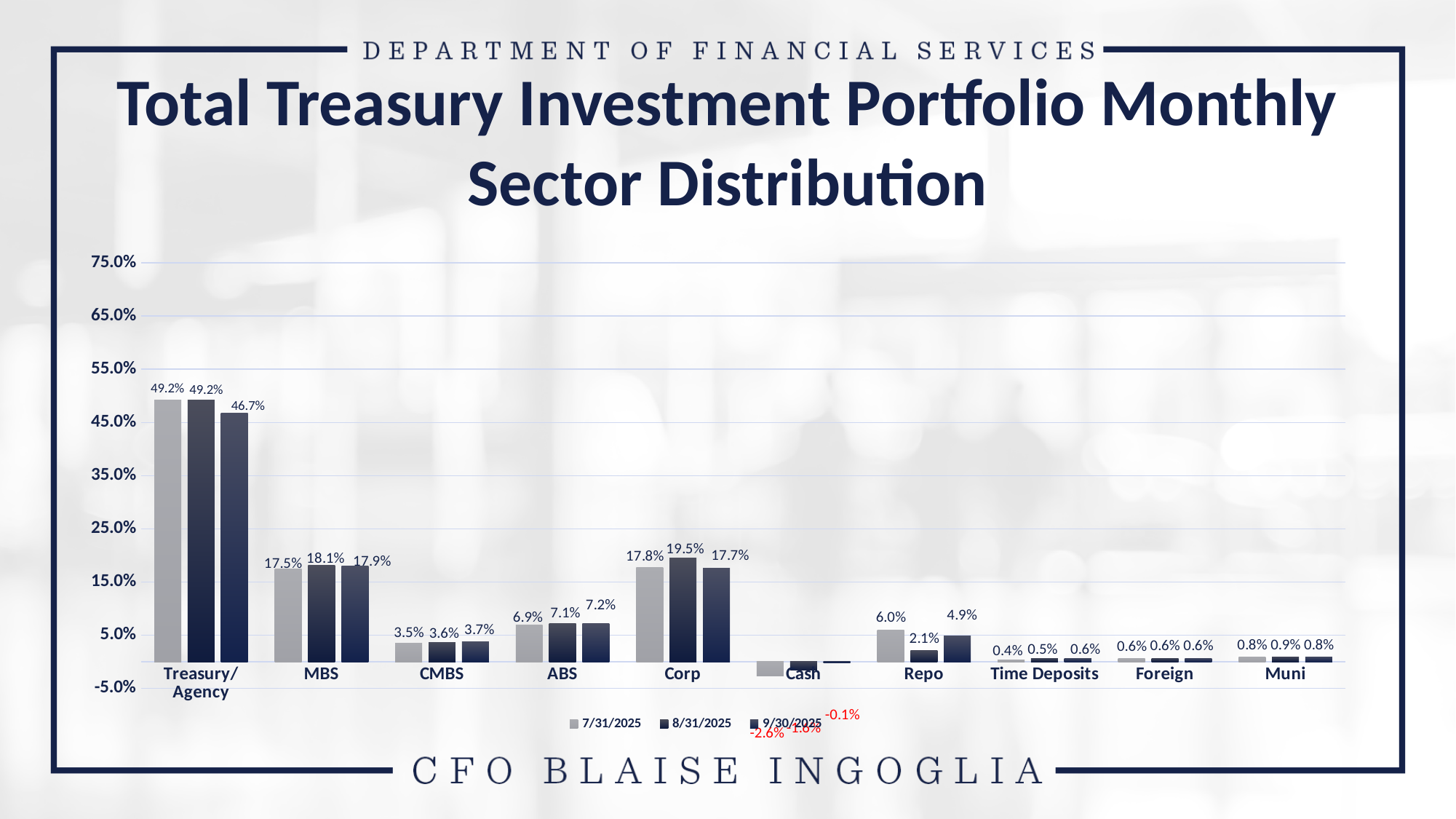
What is the value for Repo in the 7/31/2025 series? 6.0% What is the value for Cash in the 7/31/2025 series? -2.6% How many sectors are shown on the x axis? 10 What is the difference between the 8/31/2025 and 9/30/2025 values for Corp? 1.8% Which sector has the highest value in the 8/31/2025 series? Treasury/Agency Which is larger for MBS: the 7/31/2025 value or the 8/31/2025 value? 8/31/2025 What is the value for Corp in the 8/31/2025 series? 19.5% How many series does the legend list? 3 Do the values for ABS rise or fall from 7/31/2025 to 9/30/2025? Rise Which sector has the lowest value in the 9/30/2025 series? Cash What kind of chart is shown on the slide? Bar chart What is the value for Treasury/Agency in the 9/30/2025 series? 46.7%